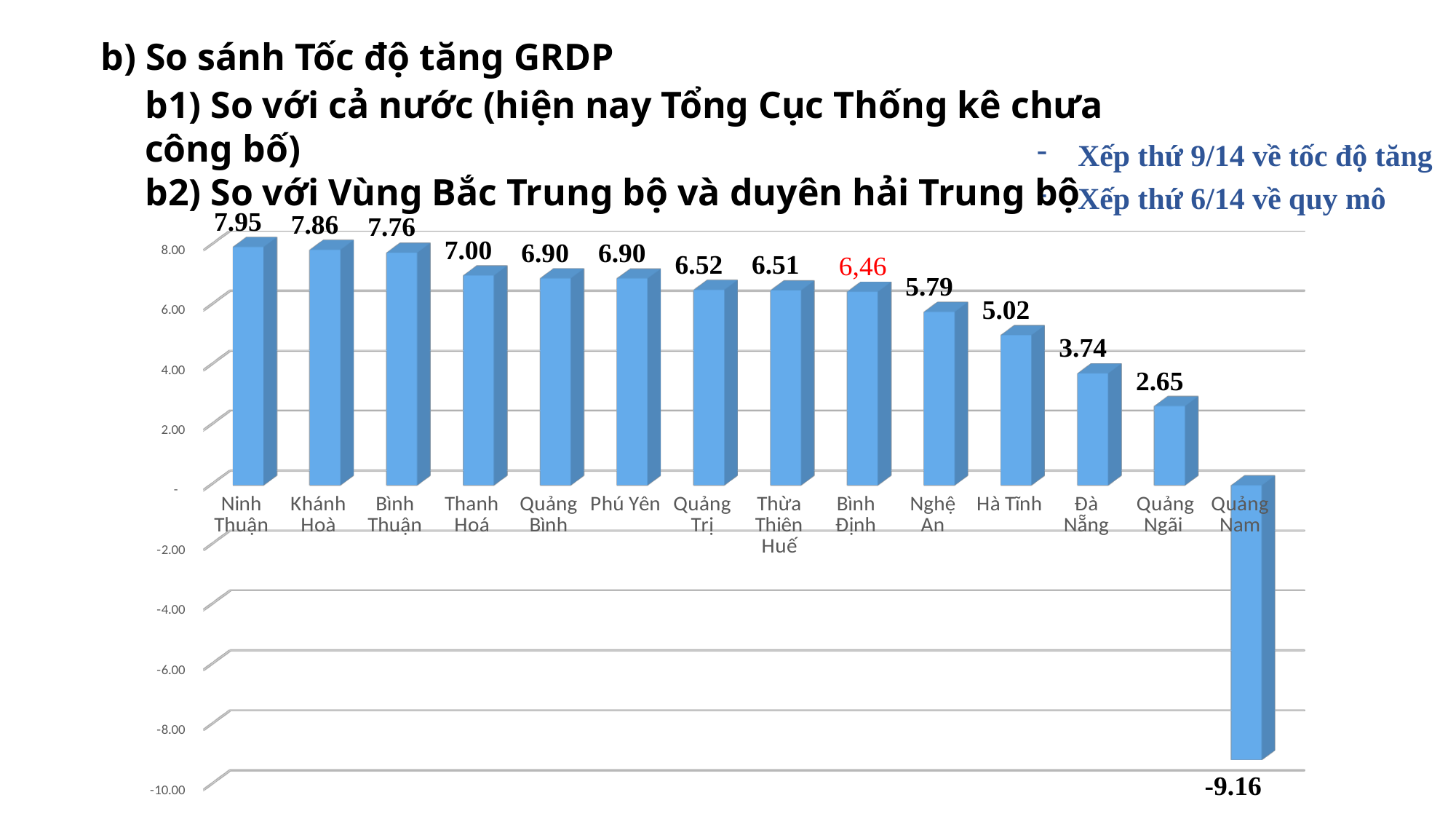
Which province has the lowest value in the chart? Quảng Nam What is the difference between the values for Nghệ An and Đà Nẵng? 2.05 Which is larger, the value for Thanh Hoá or the value for Quảng Ngãi? Thanh Hoá How many provinces are shown on the x axis of the chart? 14 What is the difference between the values for Ninh Thuận and Khánh Hoà? 0.09 What kind of chart is shown on the slide? Bar chart What is the value shown for Hà Tĩnh? 5.02 What is the value shown for Ninh Thuận? 7.95 Which province has the highest value in the chart? Ninh Thuận What is the value shown for Bình Định? 6,46 Which province's data label is printed in red? Bình Định What is the value shown for Quảng Nam? -9.16